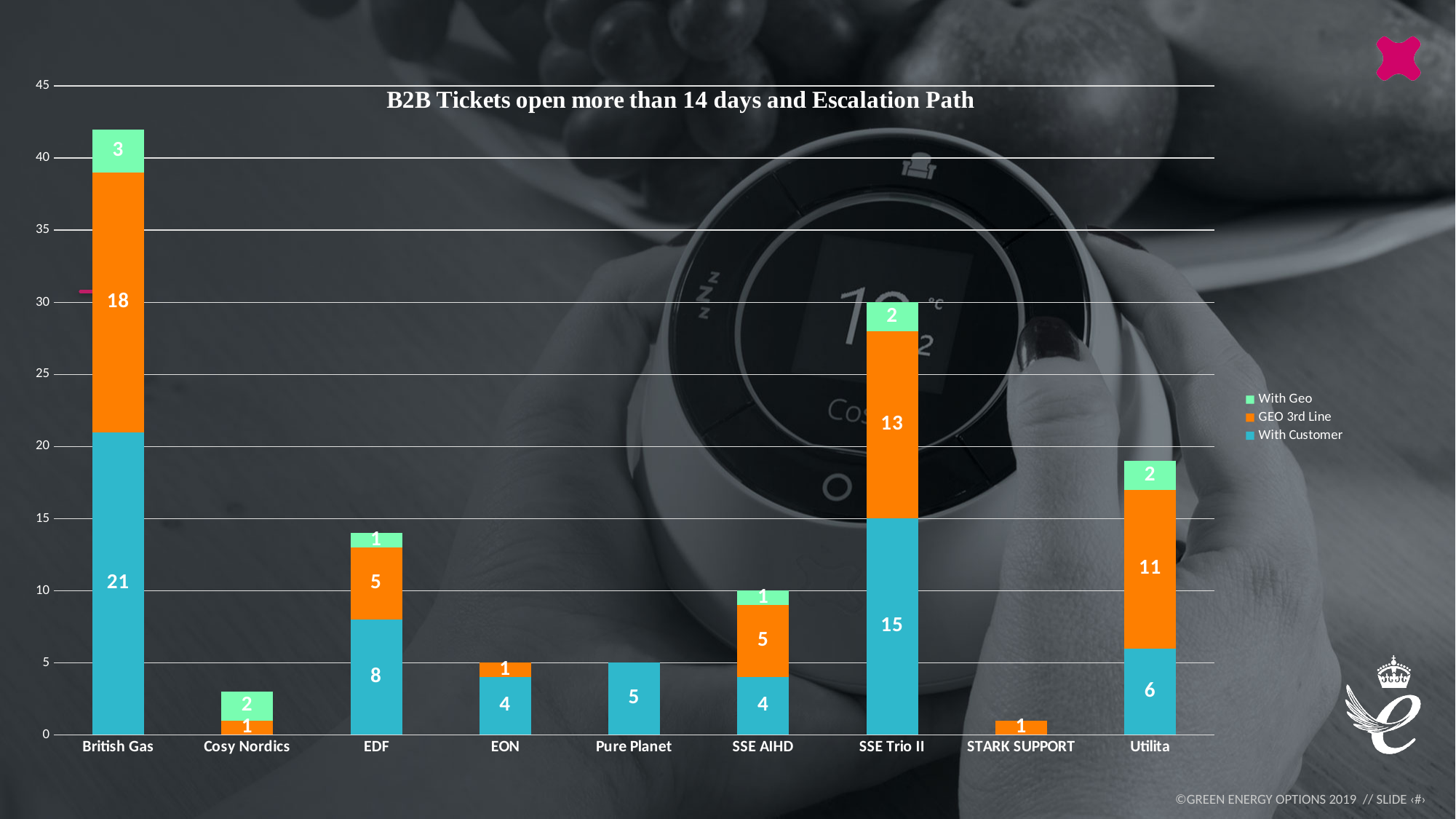
What is the With Customer value for British Gas? 21 Which category has the lowest total stacked bar? STARK SUPPORT How many categories are shown on the x axis? 9 How many series does the legend list? 3 What is the title of the chart? B2B Tickets open more than 14 days and Escalation Path What is the GEO 3rd Line value for SSE Trio II? 13 What is the difference between the GEO 3rd Line values for British Gas and Utilita? 7 What is the total of the stacked bar for SSE Trio II? 30 What kind of chart is shown on the slide? Stacked bar chart Which category has the highest With Customer value? British Gas Which is larger, the With Customer value for EDF or the With Customer value for Utilita? EDF What is the With Geo value for Utilita? 2